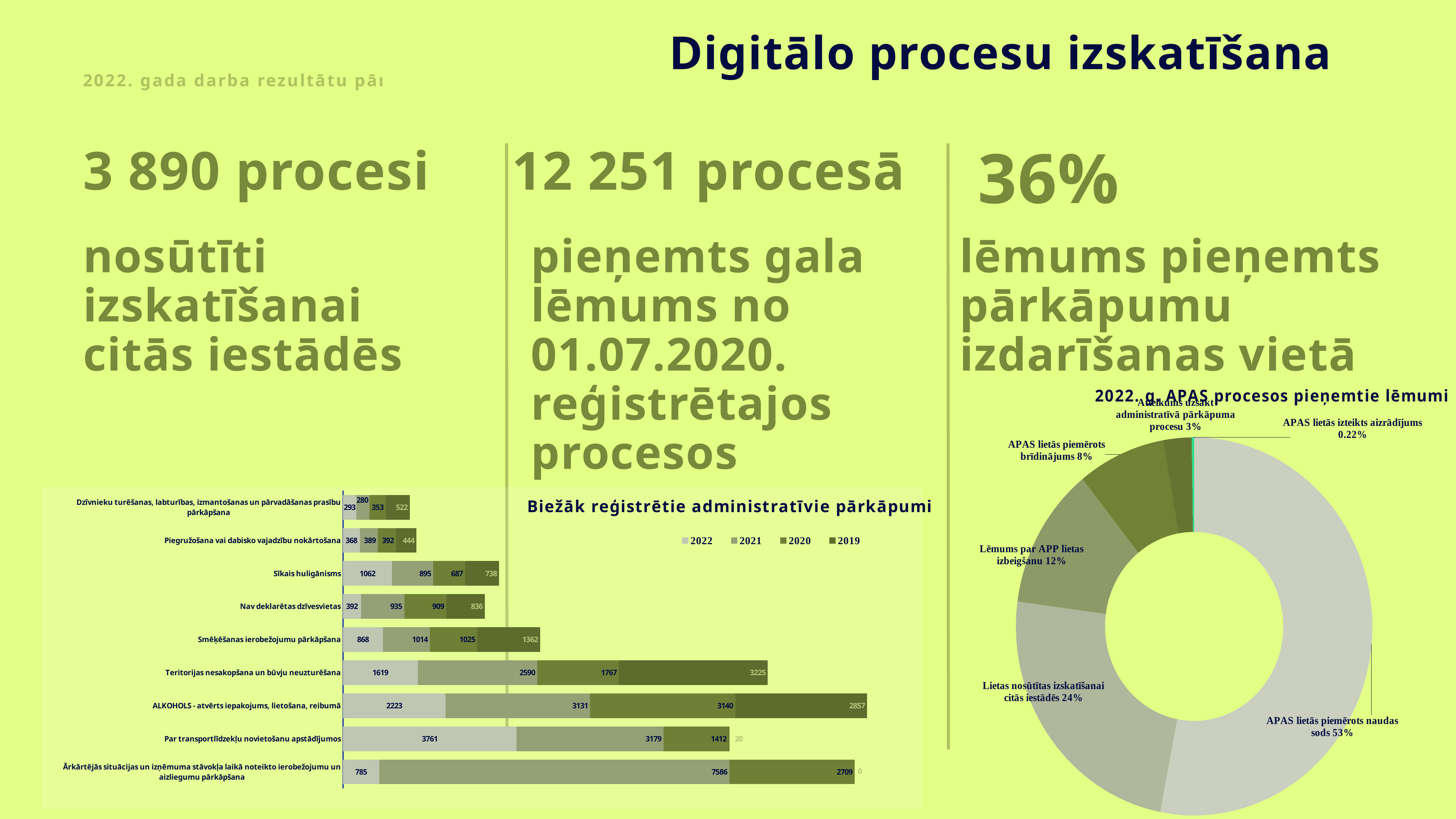
In the chart '2022. g. APAS procesos pieņemtie lēmumi', what share is 'APAS lietās piemērots naudas sods'? 53% In the chart 'Biežāk reģistrētie administratīvie pārkāpumi', what is the difference between the 2021 and 2020 values for 'Sīkais huligānisms'? 208 In the chart 'Biežāk reģistrētie administratīvie pārkāpumi', what is the 2019 value for 'Teritorijas nesakopšana un būvju neuzturēšana'? 3225 In the chart 'Biežāk reģistrētie administratīvie pārkāpumi', what is the total of the stacked bar for 'Piegružošana vai dabisko vajadzību nokārtošana'? 1593 In the chart 'Biežāk reģistrētie administratīvie pārkāpumi', how many categories are shown? 9 In the chart 'Biežāk reģistrētie administratīvie pārkāpumi', which category has the highest 2022 value? Par transportlīdzekļu novietošanu apstādījumos In the chart 'Biežāk reģistrētie administratīvie pārkāpumi', what is the 2022 value for 'Par transportlīdzekļu novietošanu apstādījumos'? 3761 In the chart 'Biežāk reģistrētie administratīvie pārkāpumi', which is larger for 'ALKOHOLS - atvērts iepakojums, lietošana, reibumā': the 2022 value or the 2019 value? 2019 What kind of chart is '2022. g. APAS procesos pieņemtie lēmumi'? Donut (pie) chart In the chart '2022. g. APAS procesos pieņemtie lēmumi', which slice is the smallest? APAS lietās izteikts aizrādījums In the chart 'Biežāk reģistrētie administratīvie pārkāpumi', how many series does the legend list? 4 In the chart 'Biežāk reģistrētie administratīvie pārkāpumi', what is the 2021 value for 'Ārkārtējās situācijas un izņēmuma stāvokļa laikā noteikto ierobežojumu un aizliegumu pārkāpšana'? 7586